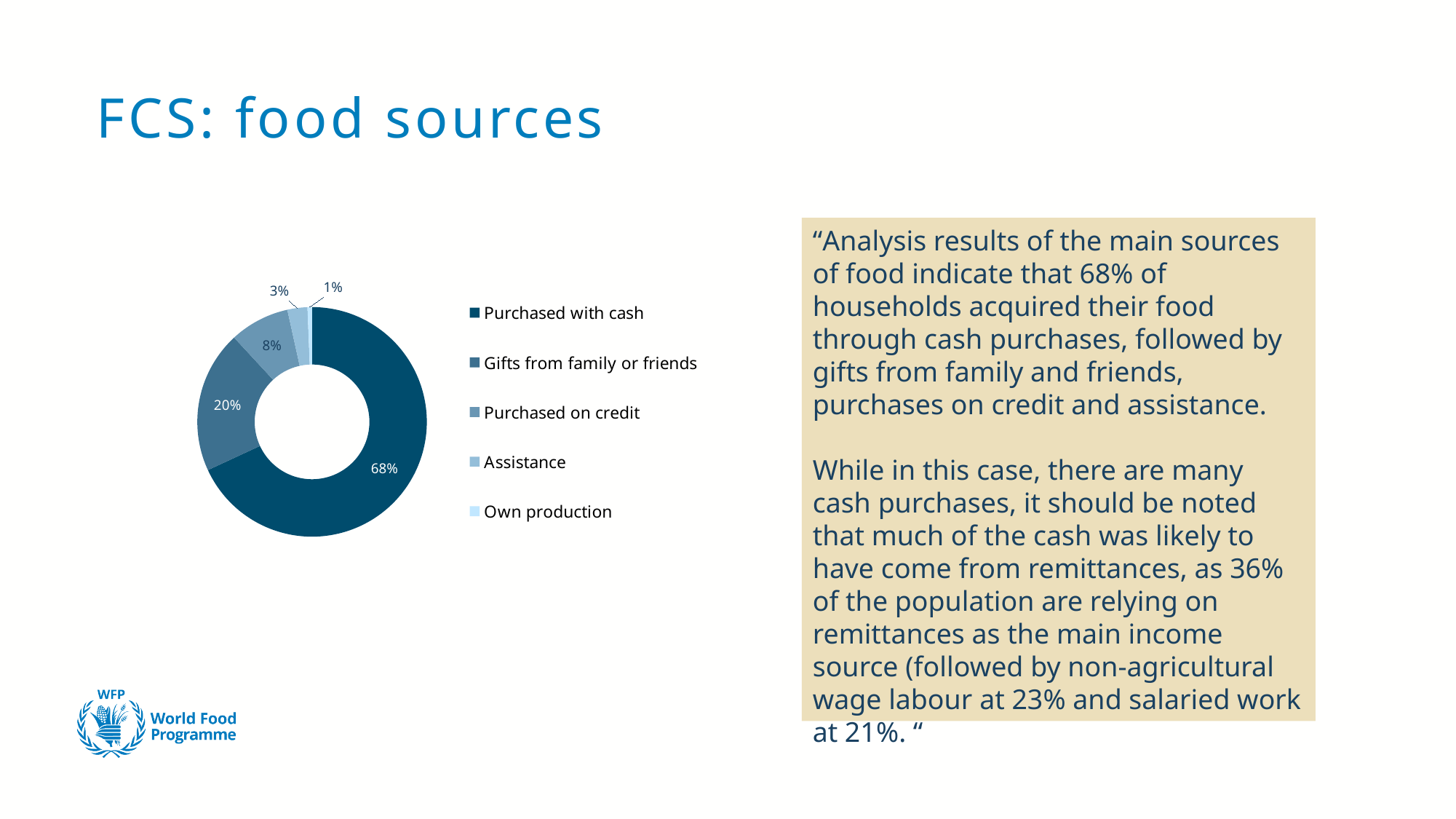
What share of food sources is Purchased with cash? 68% What is the difference in percentage points between Purchased with cash and Gifts from family or friends? 48 What is the combined share of Purchased on credit, Assistance and Own production? 12% How many food source categories are shown in the chart? 5 Which food source has the largest share of the pie? Purchased with cash What share of food sources is Gifts from family or friends? 20% What share of food sources is Own production? 1% Which food source has the smallest share of the pie? Own production What share of food sources is Purchased on credit? 8% What kind of chart is used to show the food sources? Pie chart (doughnut) What share of food sources is Assistance? 3% Which is larger, the share for Purchased on credit or the share for Assistance? Purchased on credit